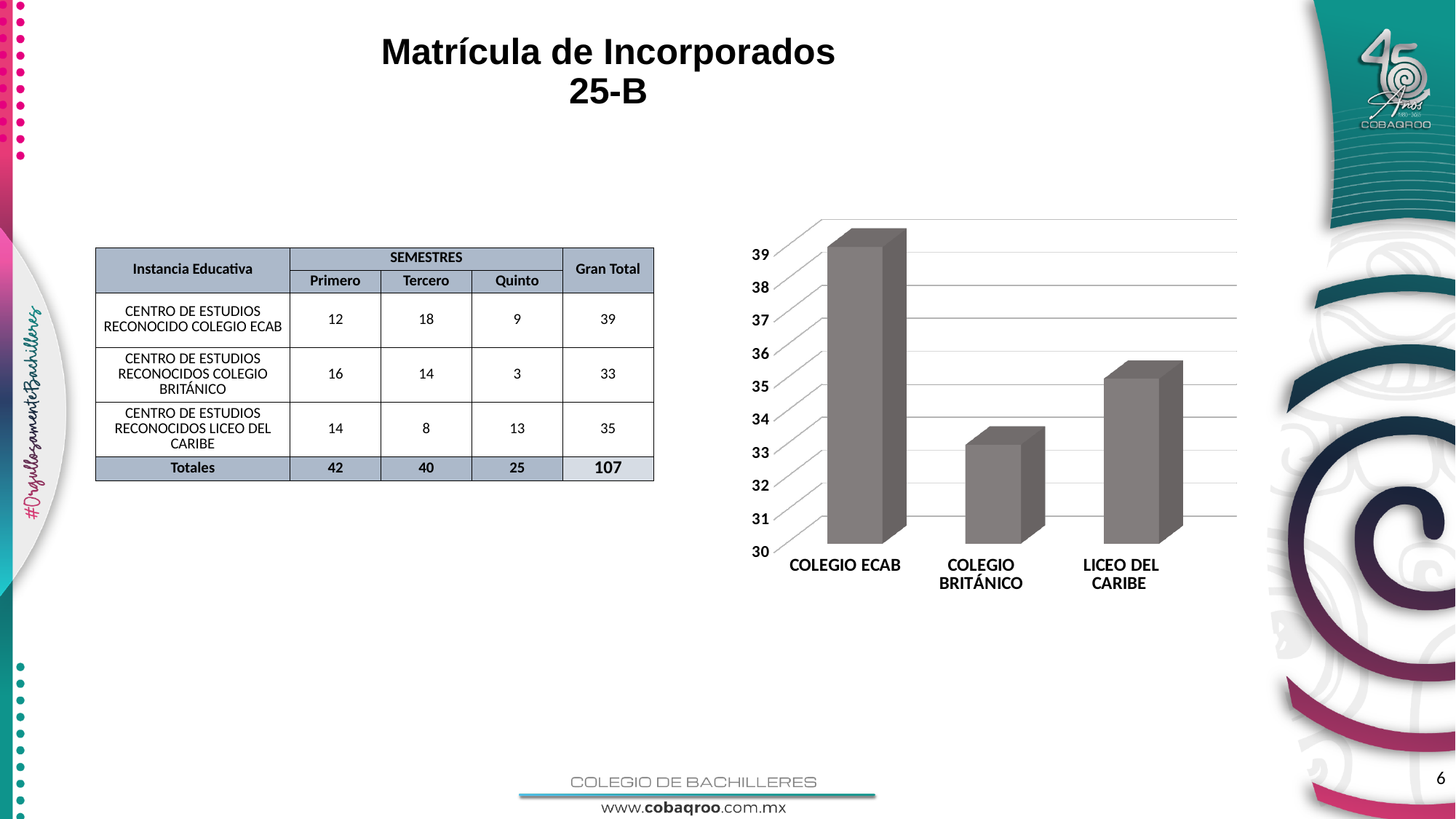
Which category has the tallest bar in the chart? COLEGIO ECAB Is the value for LICEO DEL CARIBE greater or less than 34? greater How many categories are plotted in the bar chart? 3 What is the value of the bar for COLEGIO BRITÁNICO? 33 Which bar is taller, LICEO DEL CARIBE or COLEGIO BRITÁNICO? LICEO DEL CARIBE What is the value of the bar for COLEGIO ECAB? 39 What kind of chart is shown on the slide? bar chart What is the value of the bar for LICEO DEL CARIBE? 35 Is the value for COLEGIO BRITÁNICO greater or less than 35? less What is the difference between the values for COLEGIO ECAB and COLEGIO BRITÁNICO? 6 What is the lowest value shown on the chart's vertical axis? 30 Which category has the shortest bar in the chart? COLEGIO BRITÁNICO